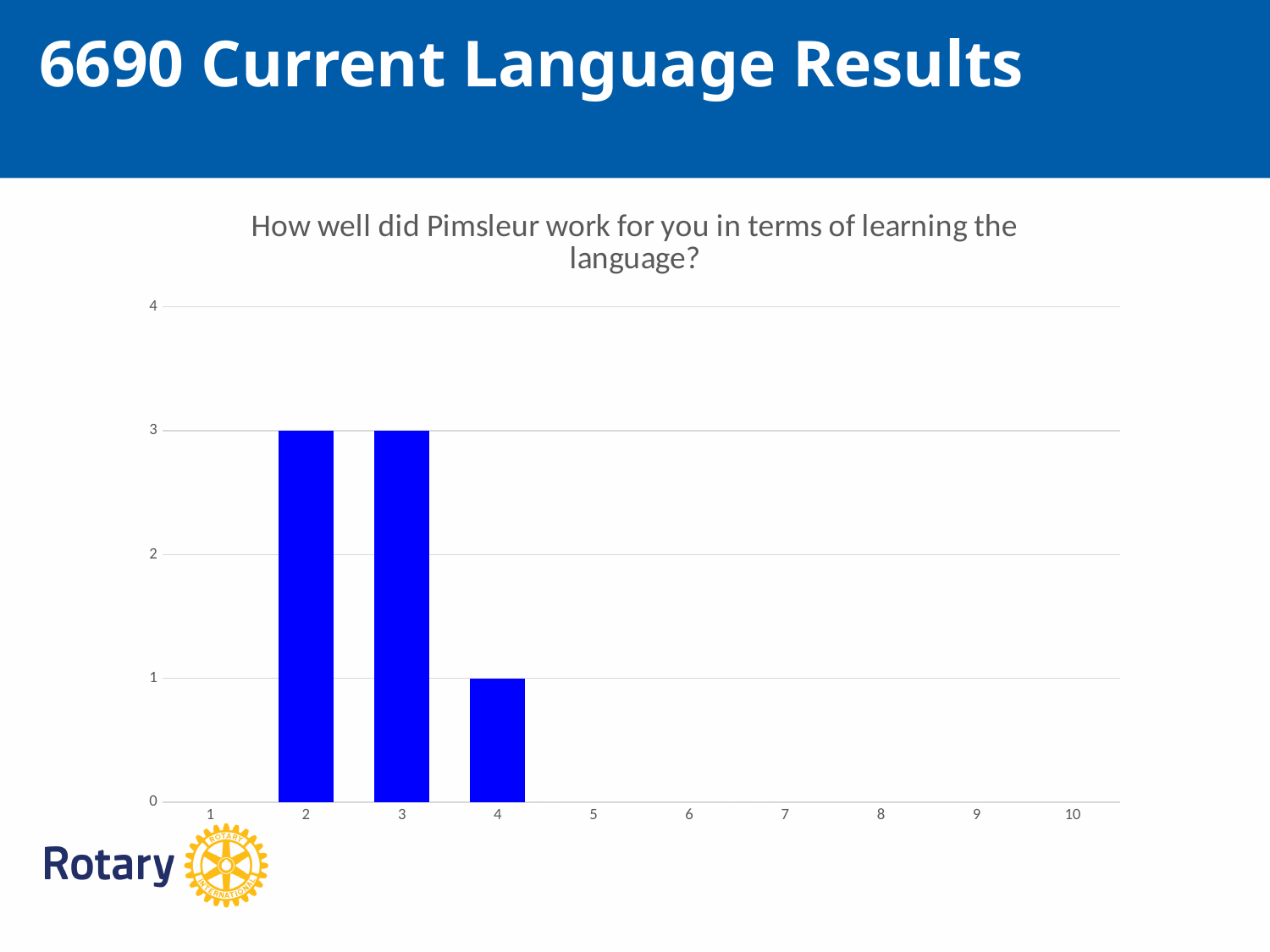
What is the value for category 4? 1 What type of chart is shown on the slide? bar chart Which category has the lowest visible bar? 4 How many categories have a visible bar? 3 How many categories are shown on the x axis? 10 What is the value for category 2? 3 What is the title of the chart? How well did Pimsleur work for you in terms of learning the language? What colour are the bars in the chart? blue What is the value for category 3? 3 Is the value for category 2 greater or less than 2? greater Which is larger, the value for category 3 or the value for category 4? category 3 What is the difference between the value for category 2 and the value for category 4? 2